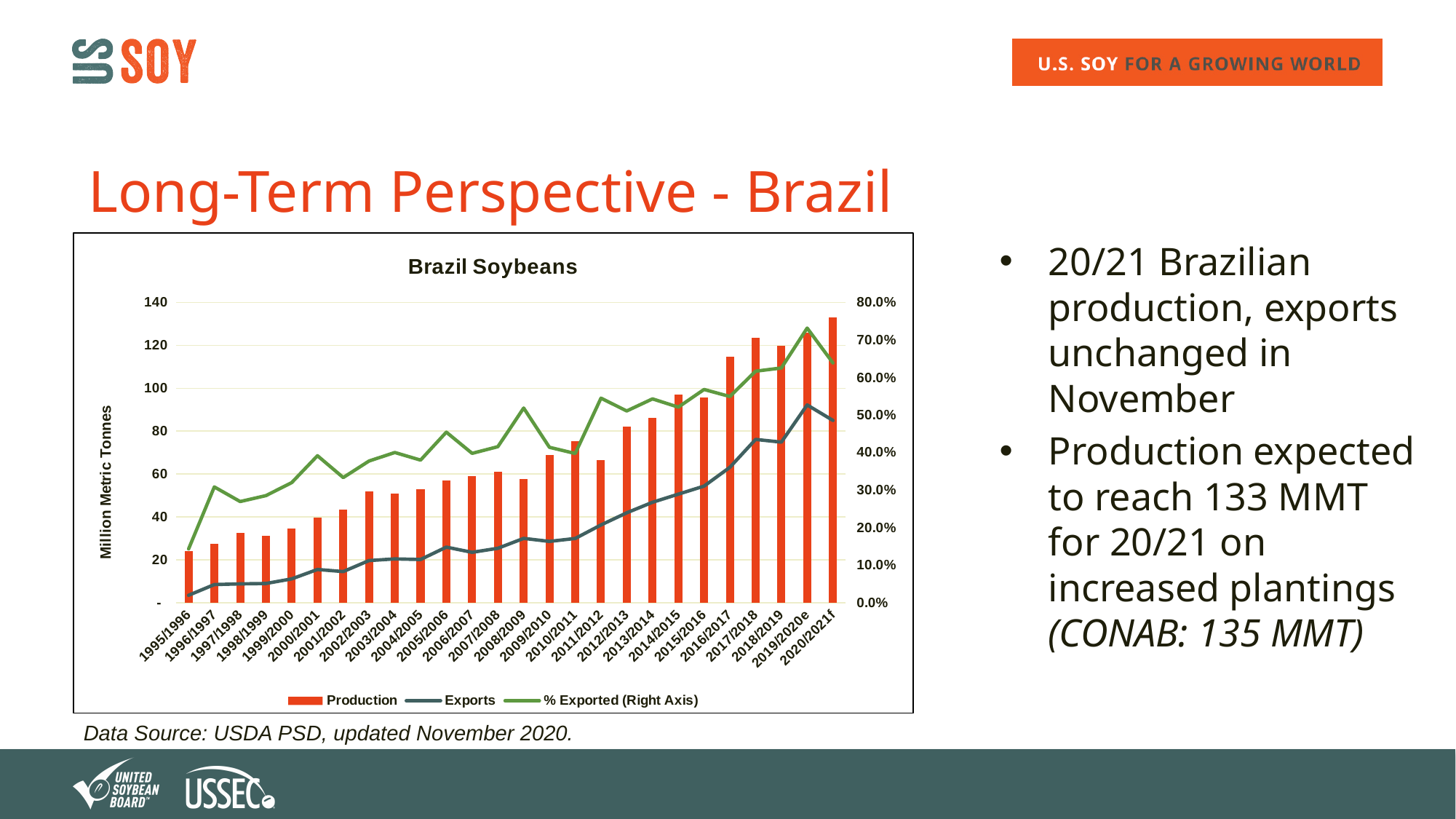
Is the Production value for 2020/2021f greater or less than 120 million metric tonnes? greater Which marketing year has the lowest Production bar in the Brazil Soybeans chart? 1995/1996 How many marketing years are shown on the x axis of the Brazil Soybeans chart? 26 How many series does the legend of the Brazil Soybeans chart list? 3 Which marketing year has the highest Production bar in the Brazil Soybeans chart? 2020/2021f Is the Production value for 1995/1996 greater or less than 40 million metric tonnes? less Is the Exports value for 2019/2020e greater or less than 80 million metric tonnes? greater Which series in the Brazil Soybeans chart is plotted on the right axis? % Exported Which is larger, the Production bar for 2020/2021f or for 2019/2020e? 2020/2021f What kind of chart is the Brazil Soybeans chart? A combination chart with bars and lines Overall, do the Production bars rise or fall from 1995/1996 to 2020/2021f? Rise